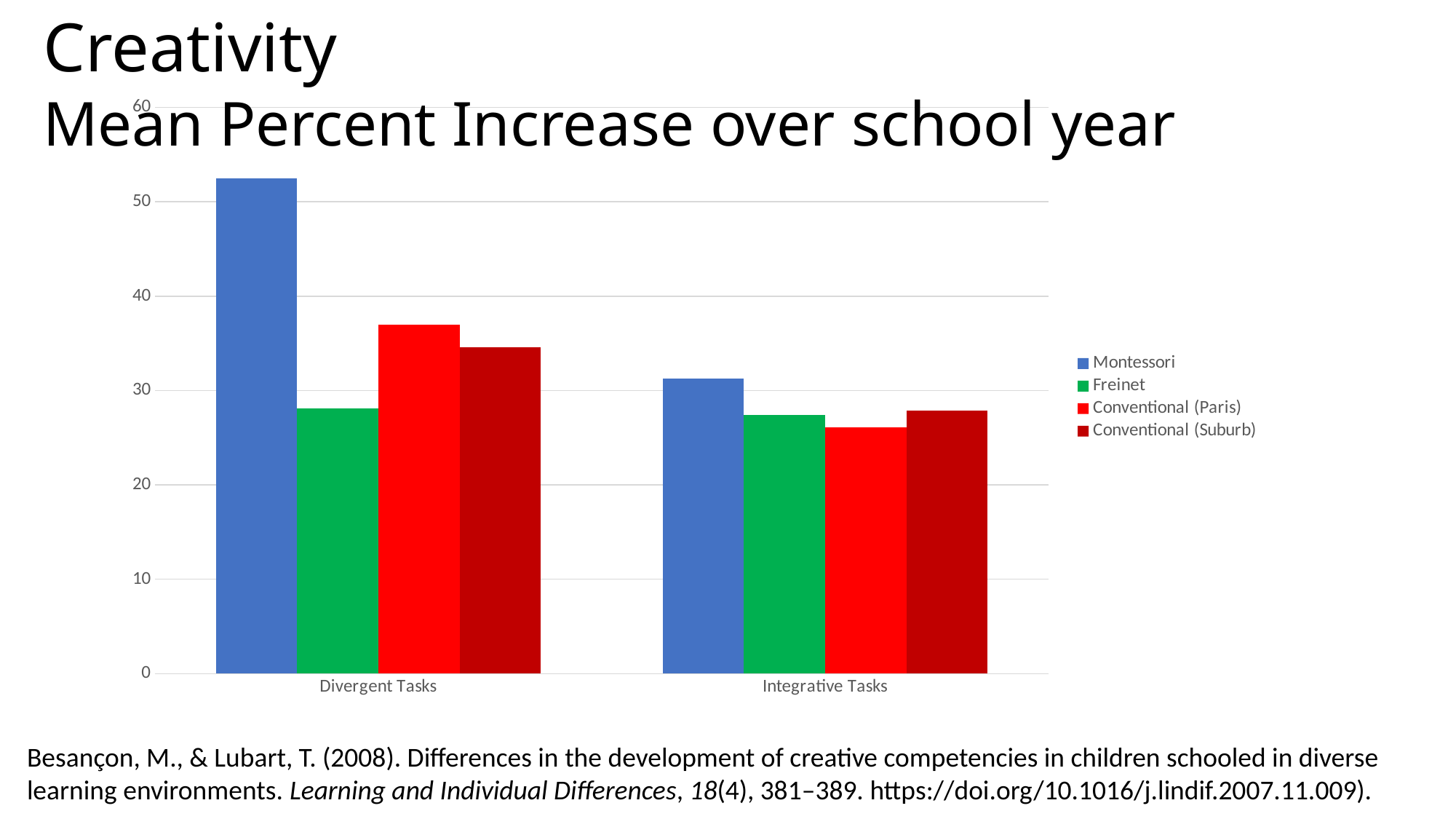
Which series has the highest value for Integrative Tasks? Montessori Is the Freinet value for Divergent Tasks greater or less than 30? less Which series has the lowest value for Divergent Tasks? Freinet Is the Montessori value for Divergent Tasks greater or less than 50? greater Which colour represents the Freinet series in the legend? green What kind of chart is shown on the slide? bar chart Which series has the highest value for Divergent Tasks? Montessori How many task categories are shown on the x axis? 2 How many series does the legend list? 4 Is the Conventional (Paris) value for Integrative Tasks greater or less than 30? less For Divergent Tasks, which is larger: Conventional (Paris) or Conventional (Suburb)? Conventional (Paris)